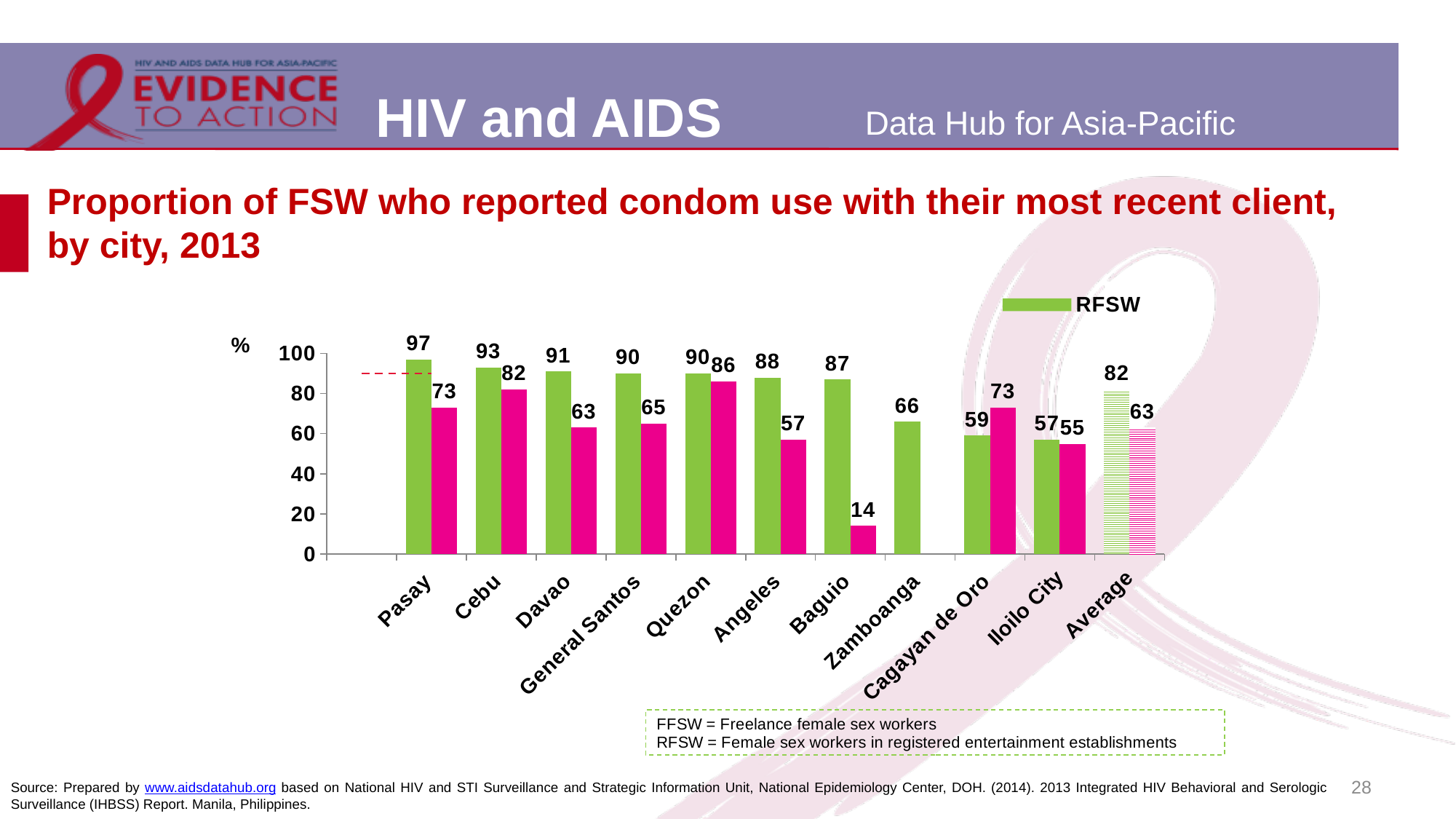
What kind of chart is shown on the slide? bar chart How many categories are shown on the x axis of the chart? 11 What is the difference between the green bar and the pink bar for Pasay? 24 What is the RFSW (green bar) value for Average? 82 Which series name is shown in the chart legend? RFSW What is the RFSW (green bar) value for Pasay? 97 Which city has the highest RFSW (green bar) value? Pasay What is the difference between the green bar and the pink bar for Baguio? 73 What is the value of the pink bar for Baguio? 14 Which city has the lowest pink bar value? Baguio What is the value of the single bar shown for Zamboanga? 66 For Cagayan de Oro, which bar is larger, the green (RFSW) bar or the pink bar? the pink bar